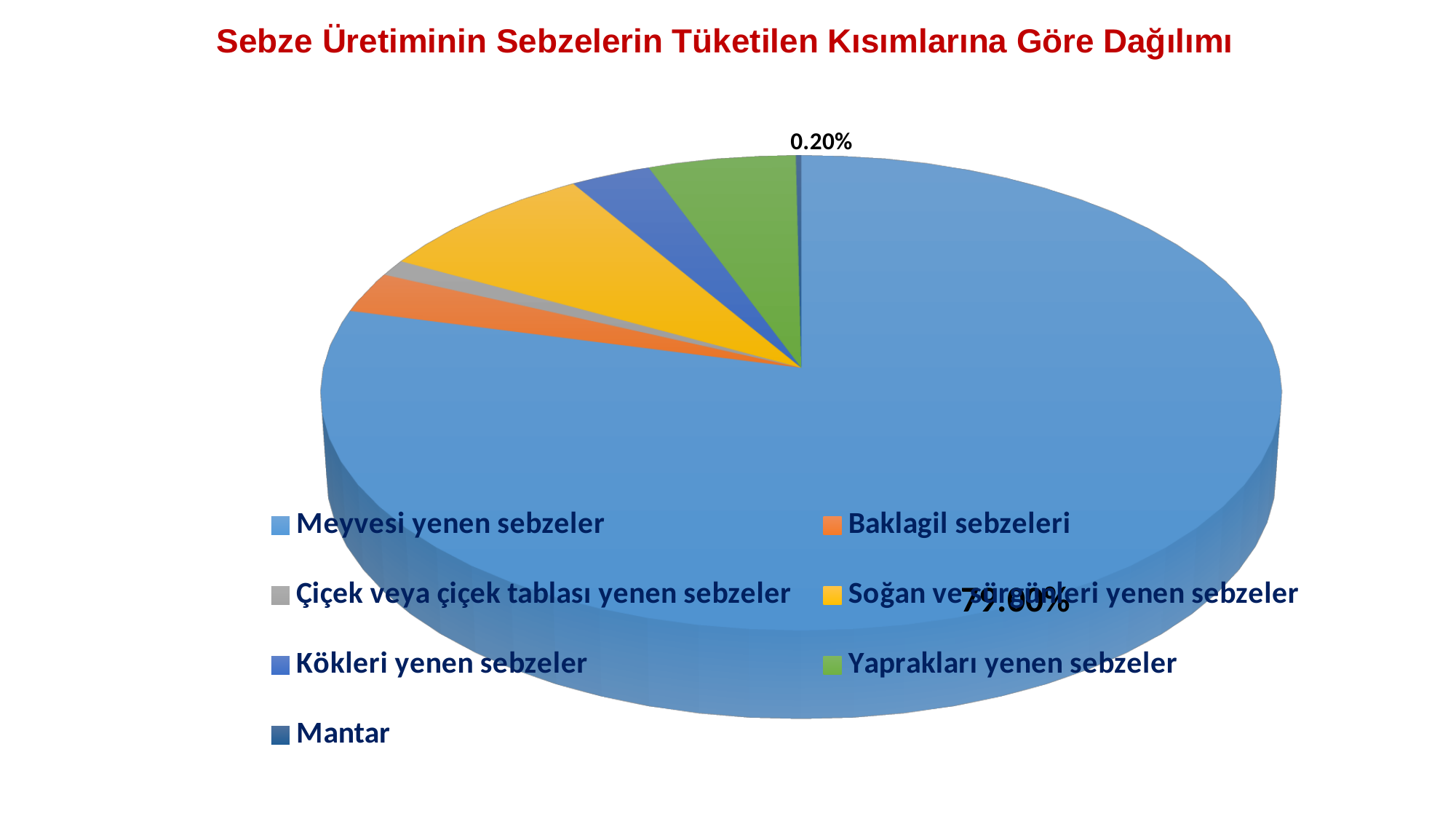
What is the difference between the share of Meyvesi yenen sebzeler and the share of Mantar? 78.80% Which slice is larger: Soğan ve sürgünleri yenen sebzeler or Baklagil sebzeleri? Soğan ve sürgünleri yenen sebzeler What colour is the slice for Meyvesi yenen sebzeler? blue Which slice is larger: Baklagil sebzeleri or Çiçek veya çiçek tablası yenen sebzeler? Baklagil sebzeleri Which category has the largest slice of the pie? Meyvesi yenen sebzeler What is the title of the chart? Sebze Üretiminin Sebzelerin Tüketilen Kısımlarına Göre Dağılımı What percentage is shown for Mantar? 0.20% Which category has the smallest slice of the pie? Mantar What percentage is shown for Meyvesi yenen sebzeler? 79.00% How many categories does the legend of the pie chart list? 7 Which slice is larger: Yaprakları yenen sebzeler or Kökleri yenen sebzeler? Yaprakları yenen sebzeler What kind of chart is shown on the slide? pie chart